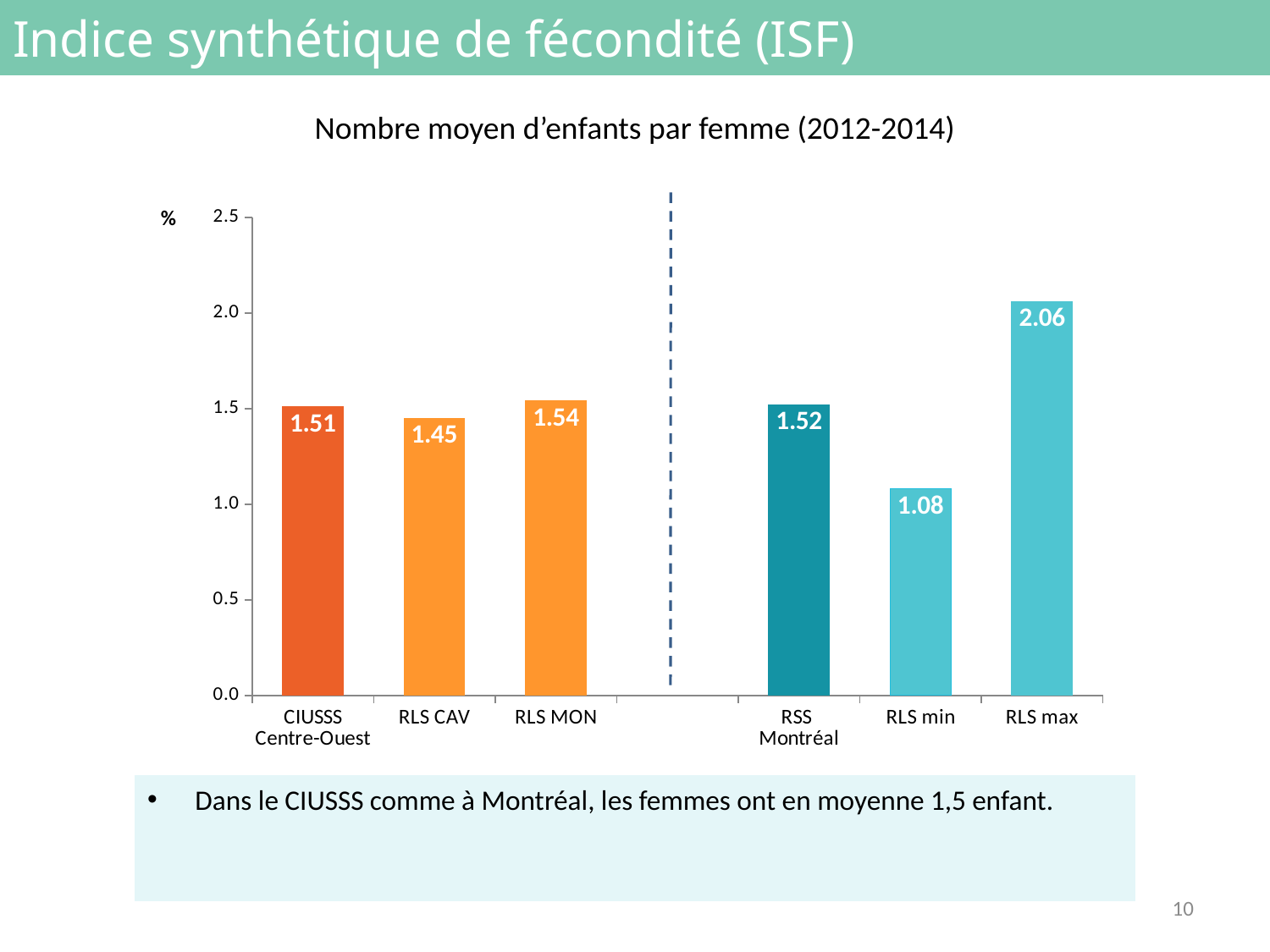
Which category has the lowest value? RLS min What kind of chart is shown on the slide? Bar chart What is the value for RSS Montréal? 1.52 Which category has the highest value? RLS max Which is larger, the value for RLS MON or the value for RLS CAV? RLS MON What is the value for RLS MON? 1.54 What is the value for RLS min? 1.08 What is the title of the chart? Nombre moyen d'enfants par femme (2012-2014) What is the difference between the values for RLS max and RLS min? 0.98 How many bars are shown in the chart? 6 What is the value for CIUSSS Centre-Ouest? 1.51 What is the value for RLS CAV? 1.45